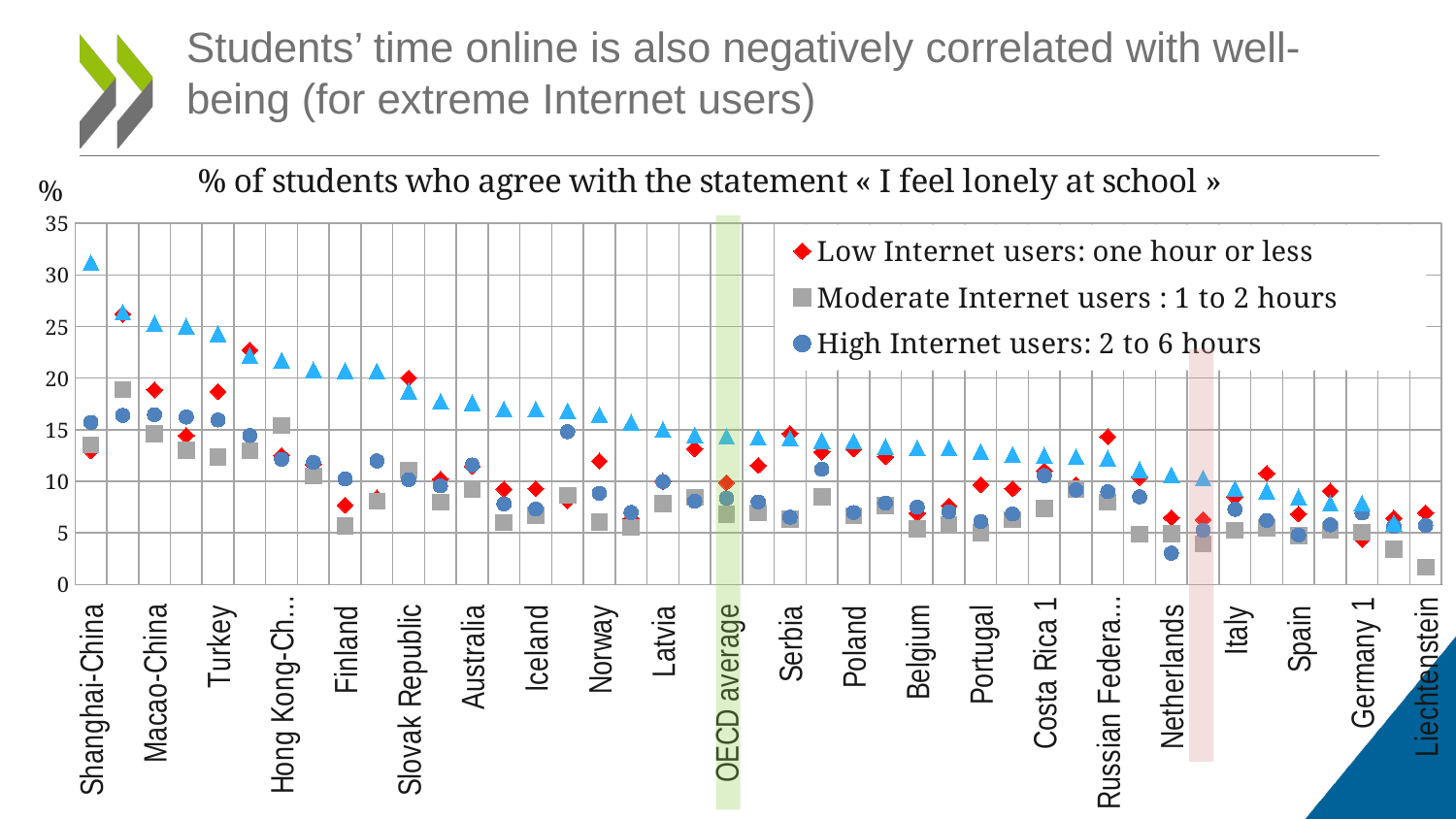
Is the value for Low Internet users in Turkey greater or less than 15? greater What kind of chart is shown on the slide? scatter chart Is the value for Moderate Internet users in Finland greater or less than 10? less Do the values for Low Internet users generally rise or fall from left to right across the countries? fall What is the title of the chart? % of students who agree with the statement « I feel lonely at school » Is the value for Moderate Internet users in Liechtenstein greater or less than 5? less How many series does the chart's legend list? 3 For Turkey, which is larger: the value for Low Internet users or for Moderate Internet users? Low Internet users Which legend entry is shown with a red diamond marker? Low Internet users: one hour or less